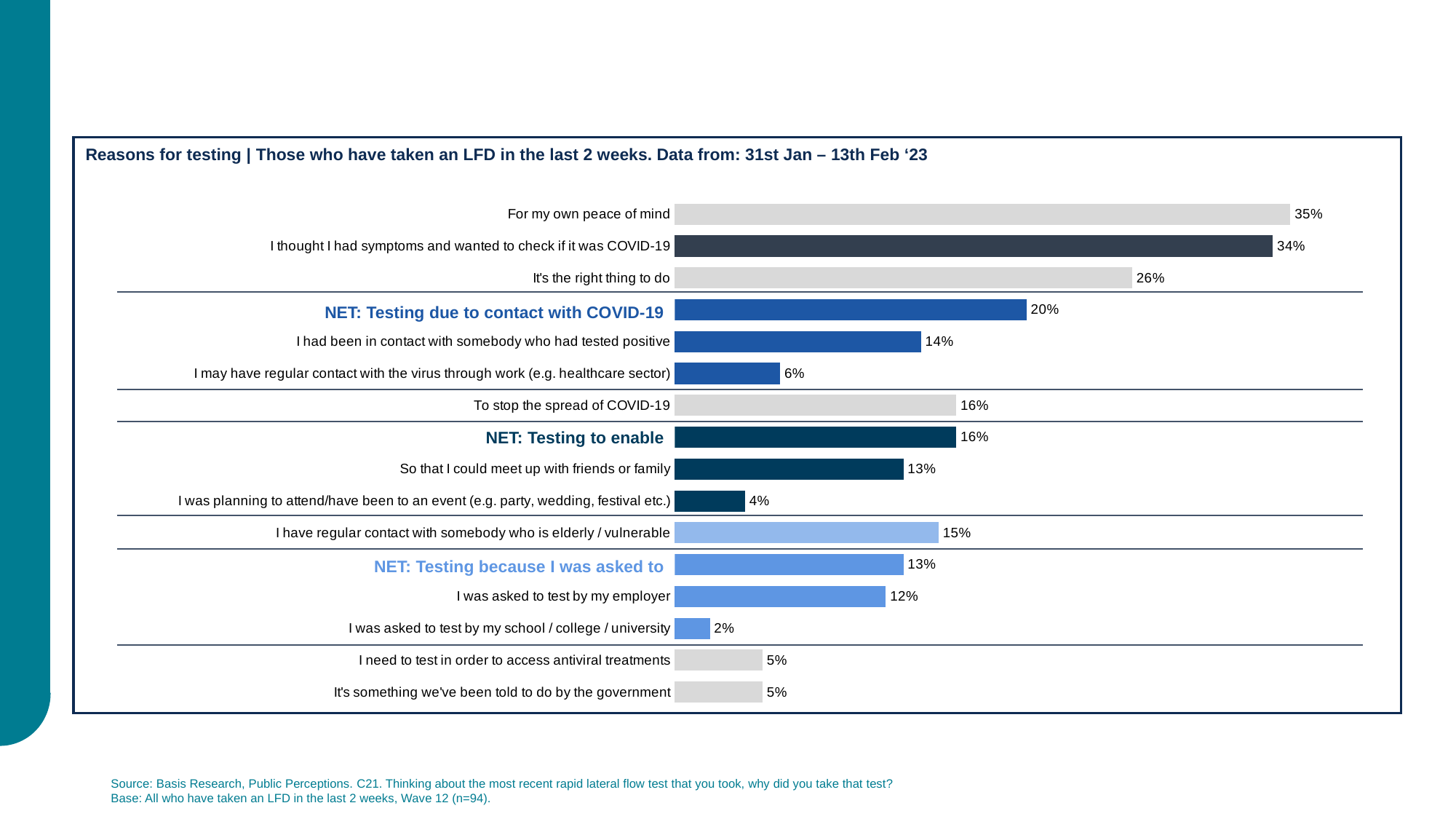
How many bars are shown in the chart? 16 What percentage of respondents tested for their own peace of mind? 35% What percentage said they were asked to test by their school / college / university? 2% Which is larger: 'To stop the spread of COVID-19' or 'So that I could meet up with friends or family'? To stop the spread of COVID-19 What is the title of the chart? Reasons for testing | Those who have taken an LFD in the last 2 weeks. Data from: 31st Jan – 13th Feb ‘23 What type of chart is shown on the slide? Bar chart Which reason for testing has the lowest percentage? I was asked to test by my school / college / university What is the value for 'I was asked to test by my employer'? 12% What is the difference between 'I had been in contact with somebody who had tested positive' and 'I may have regular contact with the virus through work (e.g. healthcare sector)'? 8% What is the difference between 'For my own peace of mind' and 'I thought I had symptoms and wanted to check if it was COVID-19'? 1% What is the value for 'NET: Testing due to contact with COVID-19'? 20% Which reason for testing has the highest percentage? For my own peace of mind